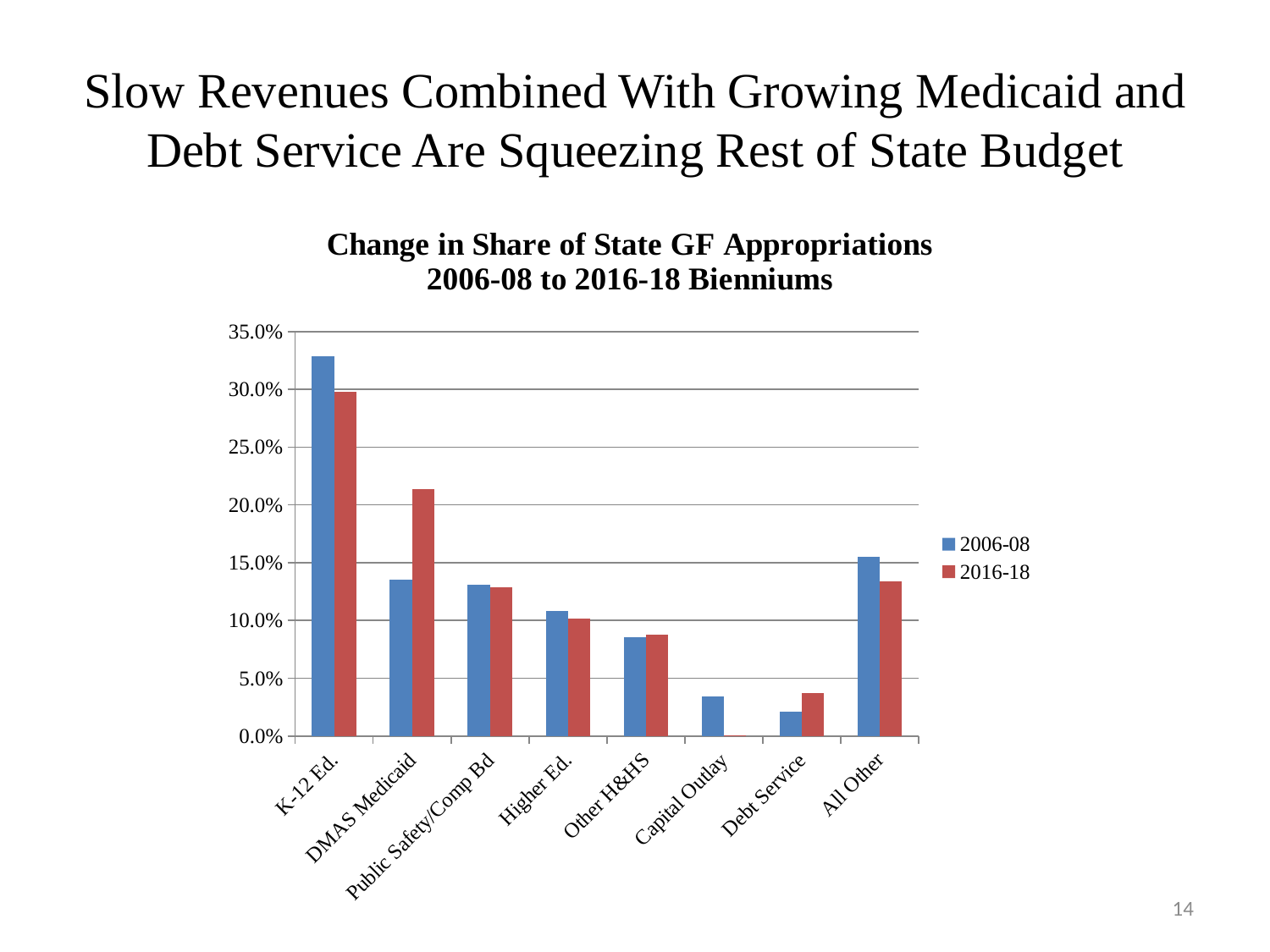
Which category has the highest value for the 2016-18 series? K-12 Ed. How many series does the legend list? 2 What are the two entries listed in the chart's legend? 2006-08 and 2016-18 Is the 2006-08 value for K-12 Ed. greater or less than 30.0%? greater Is the 2016-18 value for Debt Service greater or less than 5.0%? less Which category has the highest value for the 2006-08 series? K-12 Ed. For DMAS Medicaid, which series has the larger value, 2006-08 or 2016-18? 2016-18 Is the 2016-18 value for DMAS Medicaid greater or less than 20.0%? greater Which category has the lowest value for the 2006-08 series? Debt Service For All Other, which series has the larger value, 2006-08 or 2016-18? 2006-08 What kind of chart is shown on the slide? Bar chart How many categories are shown along the x axis? 8